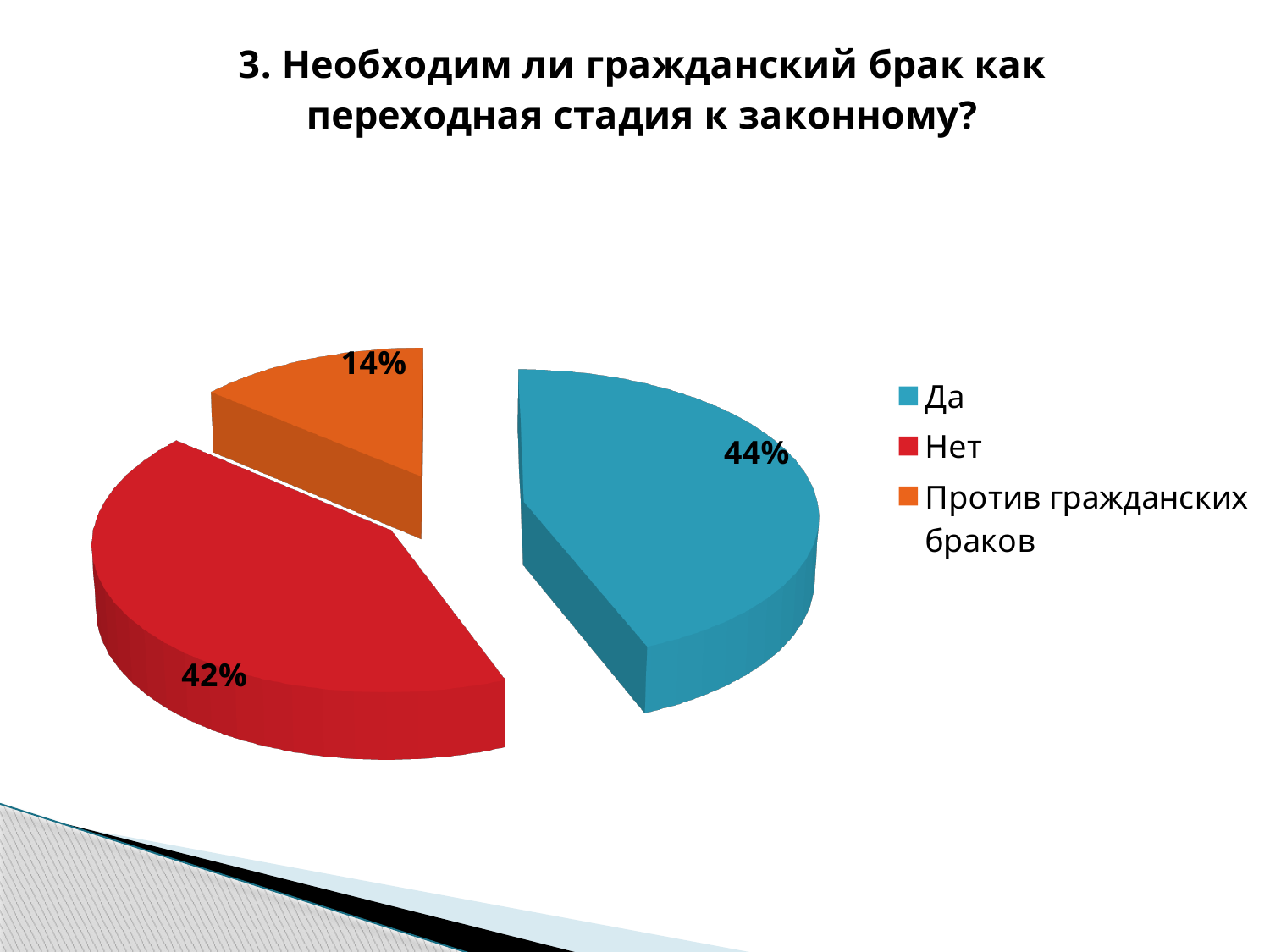
What percentage is shown for "Против гражданских браков"? 14% What is the difference in percentage points between "Да" and "Нет"? 2 Which answer has the largest share of the pie? Да What percentage of respondents answered "Да"? 44% What colour is the slice for "Против гражданских браков"? orange Which is larger, the share for "Нет" or the share for "Против гражданских браков"? Нет How many slices does the pie chart have? 3 What percentage of respondents answered "Нет"? 42% What kind of chart is shown on the slide? pie chart What is the title of the chart? 3. Необходим ли гражданский брак как переходная стадия к законному? Which answer has the smallest share of the pie? Против гражданских браков What is the difference in percentage points between "Нет" and "Против гражданских браков"? 28